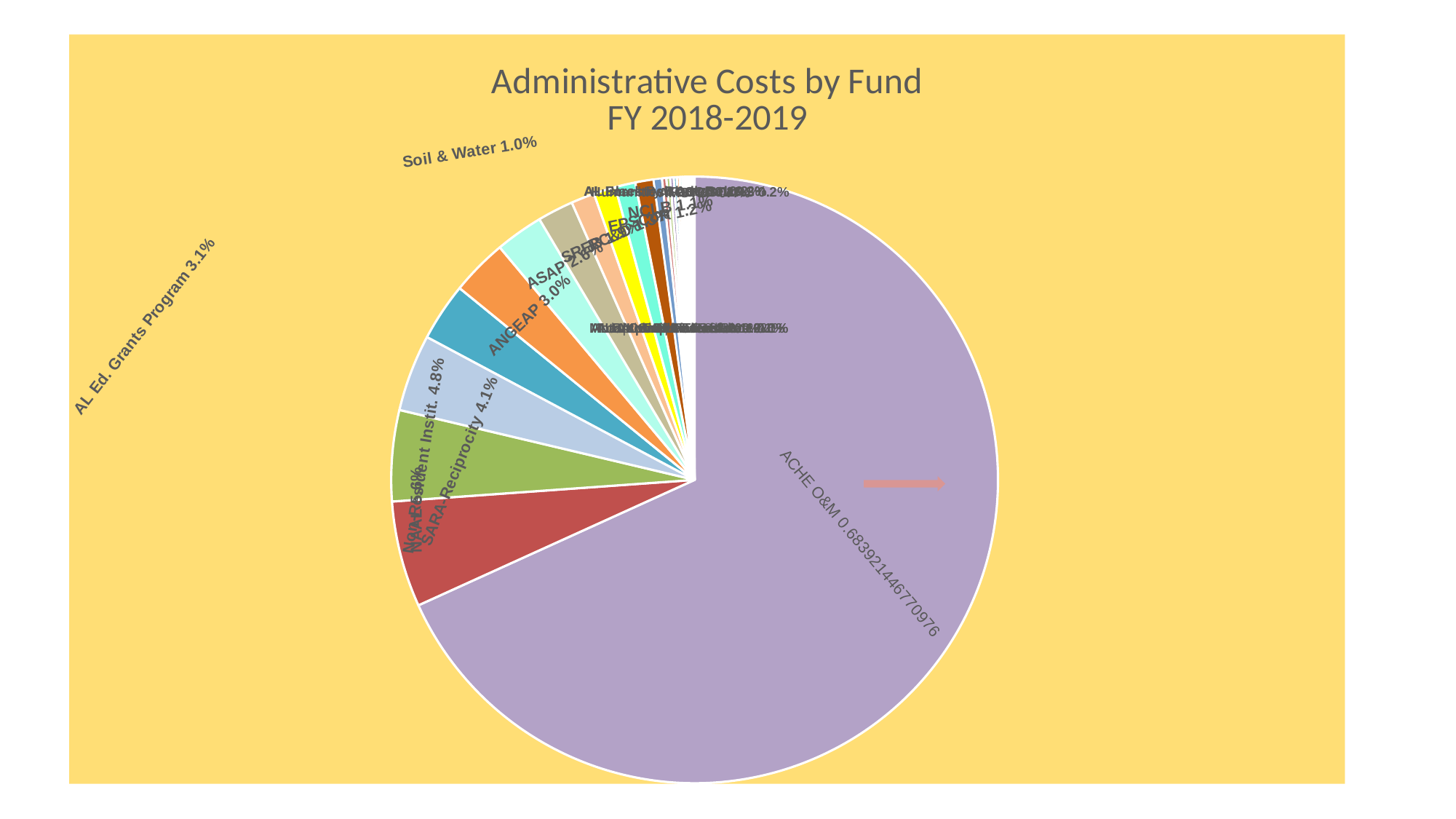
What percentage is shown for SARA-Reciprocity? 4.1% What percentage is shown for Soil & Water? 1.0% What is the difference in percentage points between Non-Resident Instit. and SARA-Reciprocity? 0.7% Which is larger, the share for SARA-Reciprocity or the share for AL Ed. Grants Program? SARA-Reciprocity What colour is the ACHE O&M slice? purple What kind of chart is shown on the slide? pie chart Which fund has the largest slice of the pie? ACHE O&M What is the title of the chart? Administrative Costs by Fund FY 2018-2019 What percentage is shown for ASAP? 2.6% What percentage is shown for ANGEAP? 3.0% What percentage is shown for Non-Resident Instit.? 4.8% What percentage is shown for AL Ed. Grants Program? 3.1%